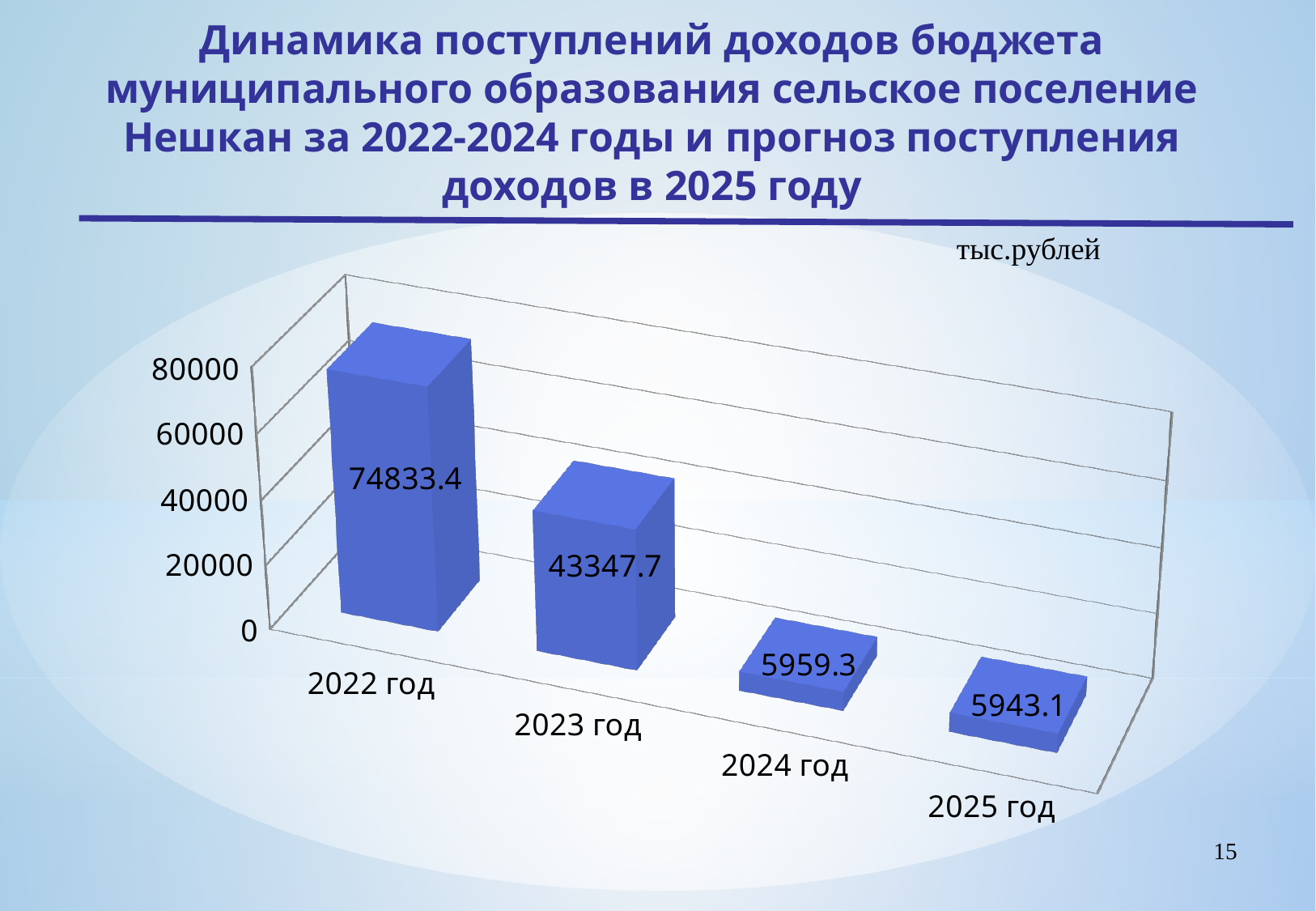
Which year has the lowest value? 2025 год Which year has the highest value? 2022 год What is the value for 2022 год? 74833.4 What is the difference between the values for 2022 год and 2023 год? 31485.7 What is the difference between the values for 2024 год and 2025 год? 16.2 What is the forecast value for 2025 год? 5943.1 How many years are shown on the chart? 4 What kind of chart is shown on the slide? bar chart Is the value for 2024 год greater or less than 20000? less What is the value for 2024 год? 5959.3 What is the value for 2023 год? 43347.7 Which is larger, the value for 2022 год or 2023 год? 2022 год